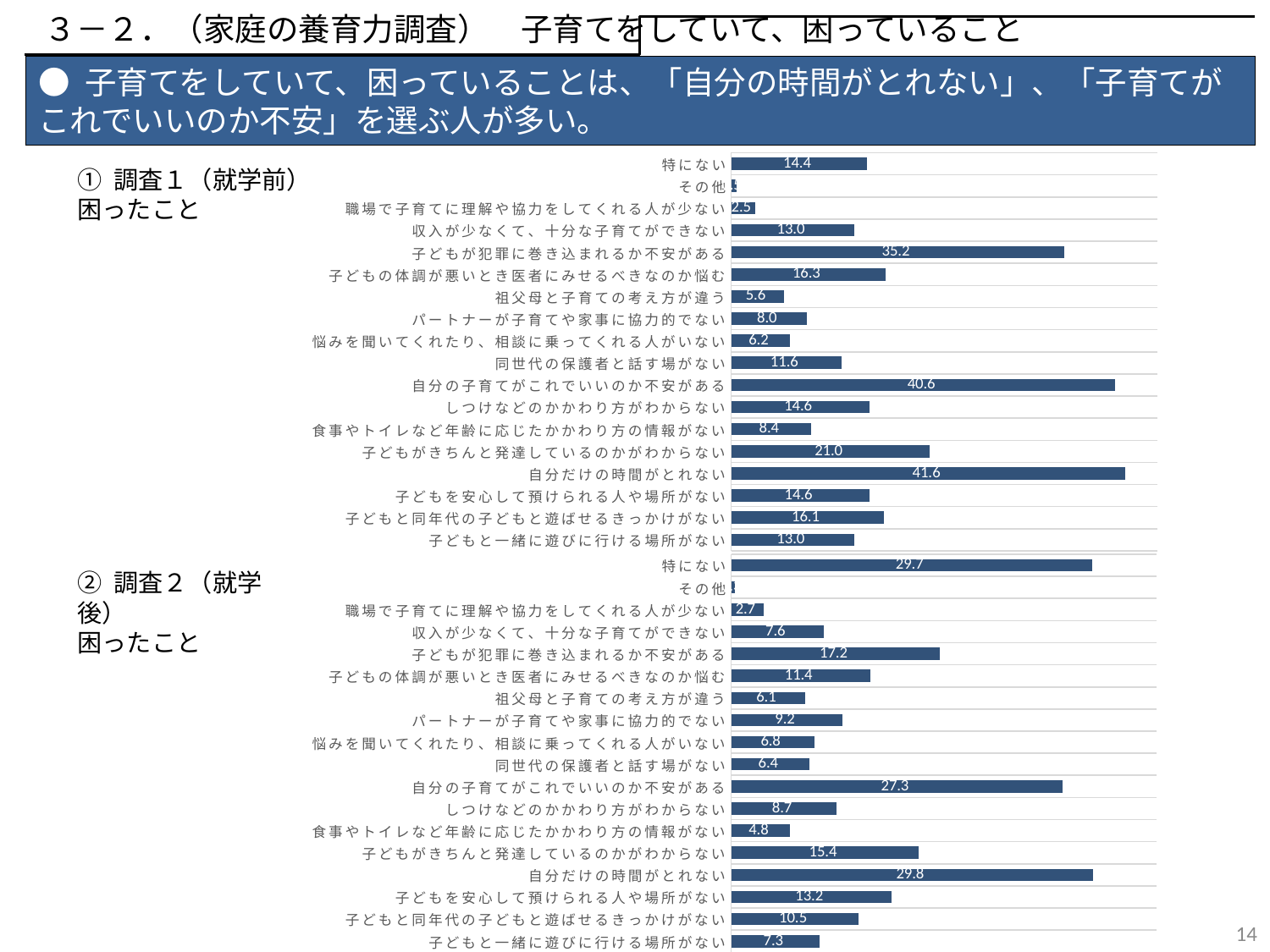
How many categories are plotted in the top chart (① 調査１（就学前）困ったこと)? 18 In the top chart (① 調査１（就学前）困ったこと), what is the value for 子どもが犯罪に巻き込まれるか不安がある? 35.2 In the bottom chart (② 調査２（就学後）困ったこと), what is the value for 自分の子育てがこれでいいのか不安がある? 27.3 In the top chart (① 調査１（就学前）困ったこと), what is the value for 自分だけの時間がとれない? 41.6 In the bottom chart (② 調査２（就学後）困ったこと), which is larger: 子どもがきちんと発達しているのかがわからない or 食事やトイレなど年齢に応じたかかわり方の情報がない? 子どもがきちんと発達しているのかがわからない In the top chart (① 調査１（就学前）困ったこと), what is the value for 子どもがきちんと発達しているのかがわからない? 21.0 In the top chart (① 調査１（就学前）困ったこと), what is the difference between 自分だけの時間がとれない and 子どもが犯罪に巻き込まれるか不安がある? 6.4 In the bottom chart (② 調査２（就学後）困ったこと), what is the difference between 特にない and 子どもが犯罪に巻き込まれるか不安がある? 12.5 Which is larger: 子どもが犯罪に巻き込まれるか不安がある in the top chart (調査１) or in the bottom chart (調査２)? Top chart (調査１) In the top chart (① 調査１（就学前）困ったこと), which category has the highest value? 自分だけの時間がとれない What kind of chart is used for ② 調査２（就学後）困ったこと? Bar chart In the bottom chart (② 調査２（就学後）困ったこと), what is the value for 特にない? 29.7